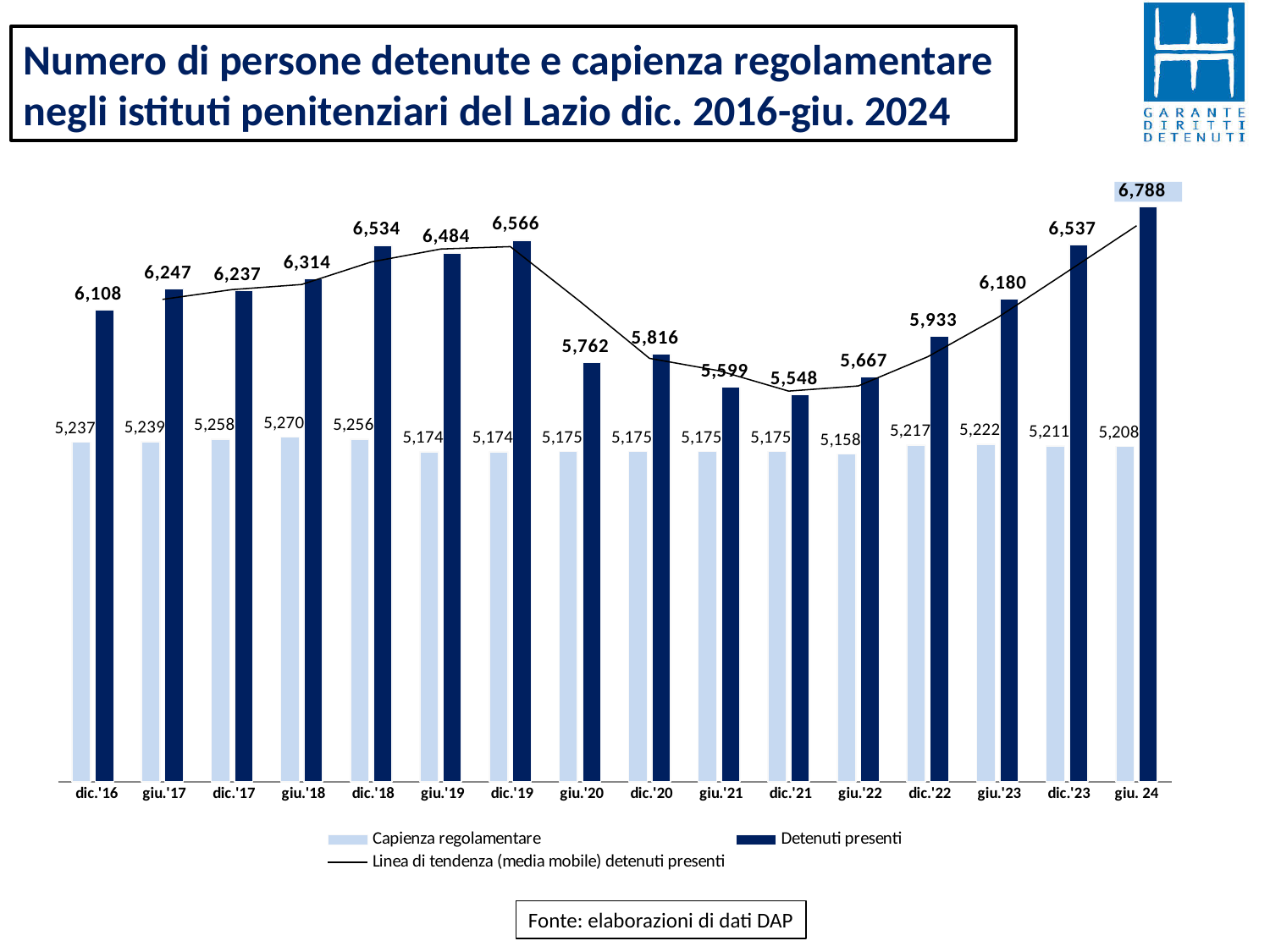
What kind of chart is shown on the slide? Bar chart with a trend line What is the Capienza regolamentare value for dic.'16? 5,237 What is the value of Detenuti presenti for giu. 24? 6,788 In which period is the Detenuti presenti value highest? giu. 24 How many entries does the legend list? 3 In which period is the Detenuti presenti value lowest? dic.'21 Which period has a higher Detenuti presenti value, dic.'18 or giu.'19? dic.'18 In which period is the Capienza regolamentare value lowest? giu.'22 What is the legend label of the line series? Linea di tendenza (media mobile) detenuti presenti How many periods are shown on the x axis? 16 By how much did Detenuti presenti fall from dic.'19 to giu.'20? 804 What is the difference between Detenuti presenti and Capienza regolamentare in giu. 24? 1,580